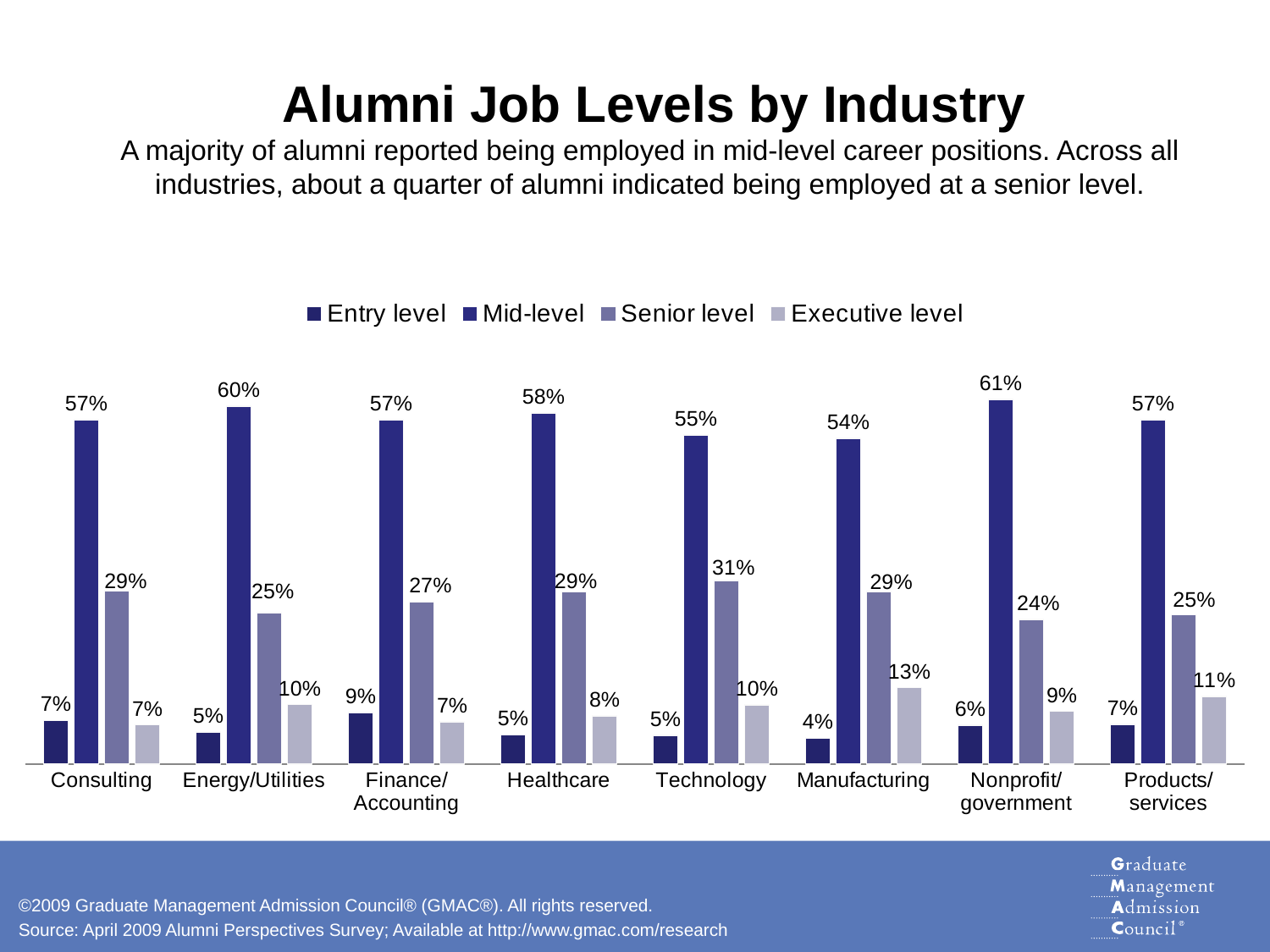
Which is larger: the Executive level value for Products/services or for Energy/Utilities? Products/services How many series does the legend list? 4 Which industry has the highest Mid-level percentage? Nonprofit/government What is the difference between the Mid-level percentages for Nonprofit/government and Manufacturing? 7 percentage points Which industry has the highest Senior level percentage? Technology What is the Mid-level value for Nonprofit/government? 61% What percentage of Technology alumni reported being at the senior level? 31% What percentage of Manufacturing alumni are at the executive level? 13% What type of chart is shown on the slide? Bar chart Which industry has the lowest Entry level percentage? Manufacturing How many industries are shown on the x axis? 8 What is the Entry level value for Finance/Accounting? 9%